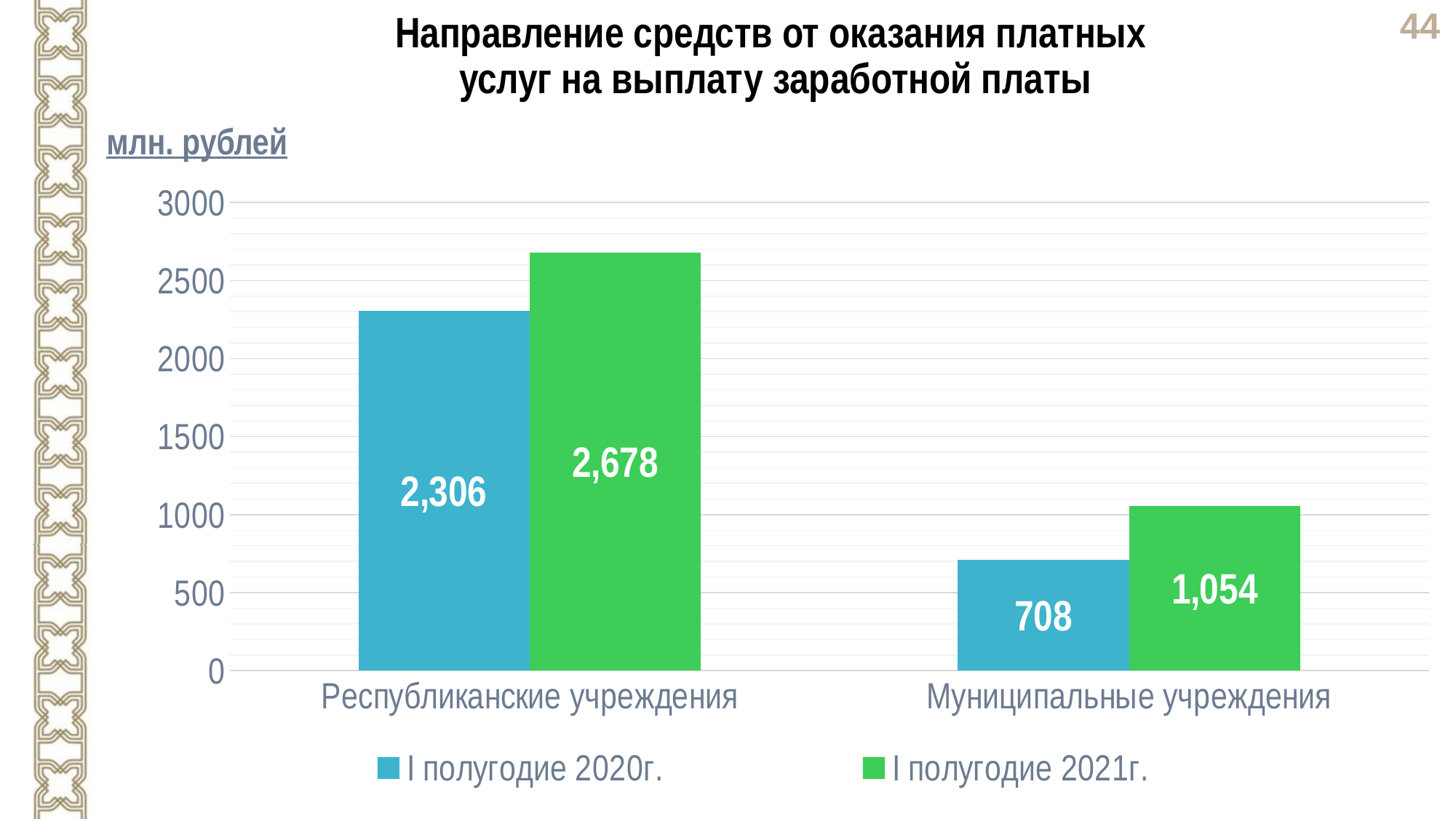
Which bar has the highest value on the chart? Республиканские учреждения, I полугодие 2021г. What is the value for Республиканские учреждения in I полугодие 2021г.? 2,678 How many categories are shown on the x axis? 2 What is the value for Республиканские учреждения in I полугодие 2020г.? 2,306 What is the difference between the I полугодие 2021г. and I полугодие 2020г. values for Муниципальные учреждения? 346 What kind of chart is shown on the slide? Bar chart Which is larger: the I полугодие 2020г. value for Республиканские учреждения or the I полугодие 2021г. value for Муниципальные учреждения? Республиканские учреждения, I полугодие 2020г. How many series does the legend list? 2 Which bar has the lowest value on the chart? Муниципальные учреждения, I полугодие 2020г. What is the value for Муниципальные учреждения in I полугодие 2021г.? 1,054 What is the value for Муниципальные учреждения in I полугодие 2020г.? 708 What is the difference between the I полугодие 2021г. and I полугодие 2020г. values for Республиканские учреждения? 372